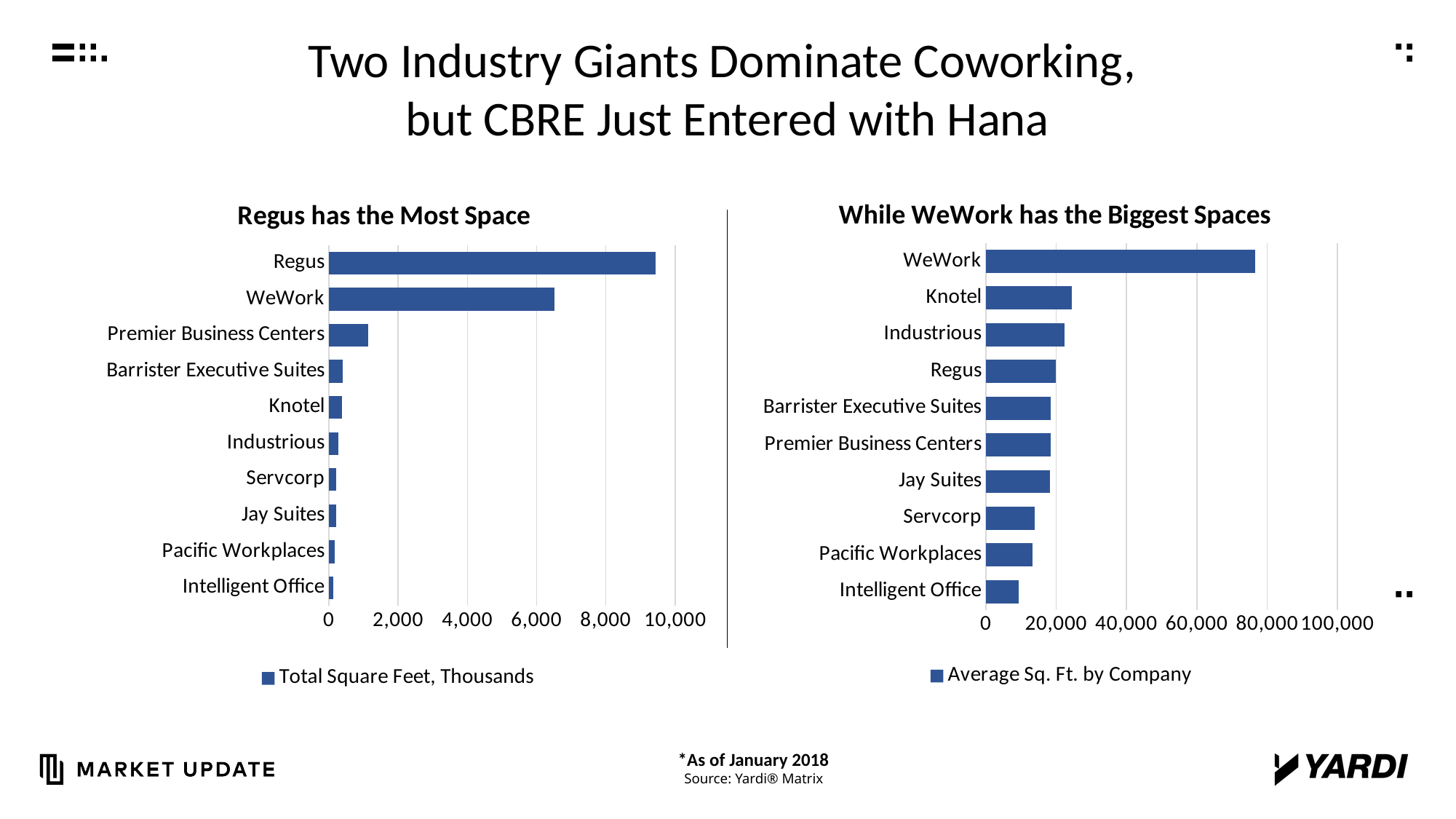
In the left chart "Regus has the Most Space", is the value for Premier Business Centers greater or less than 2,000? less In the left chart "Regus has the Most Space", which company has the highest value? Regus What is the legend entry of the left chart "Regus has the Most Space"? Total Square Feet, Thousands In the right chart "While WeWork has the Biggest Spaces", which company has the lowest value? Intelligent Office In the right chart "While WeWork has the Biggest Spaces", which company has the highest value? WeWork In the right chart "While WeWork has the Biggest Spaces", is the value for WeWork greater or less than 60,000? greater What kind of chart is the left chart titled "Regus has the Most Space"? bar chart In the left chart "Regus has the Most Space", which company has the lowest value? Intelligent Office How many companies are shown in the left chart "Regus has the Most Space"? 10 In the right chart "While WeWork has the Biggest Spaces", which is larger, the value for WeWork or the value for Knotel? WeWork In the left chart "Regus has the Most Space", is the value for Regus greater or less than 8,000? greater How many series does the legend of the right chart "While WeWork has the Biggest Spaces" list? 1